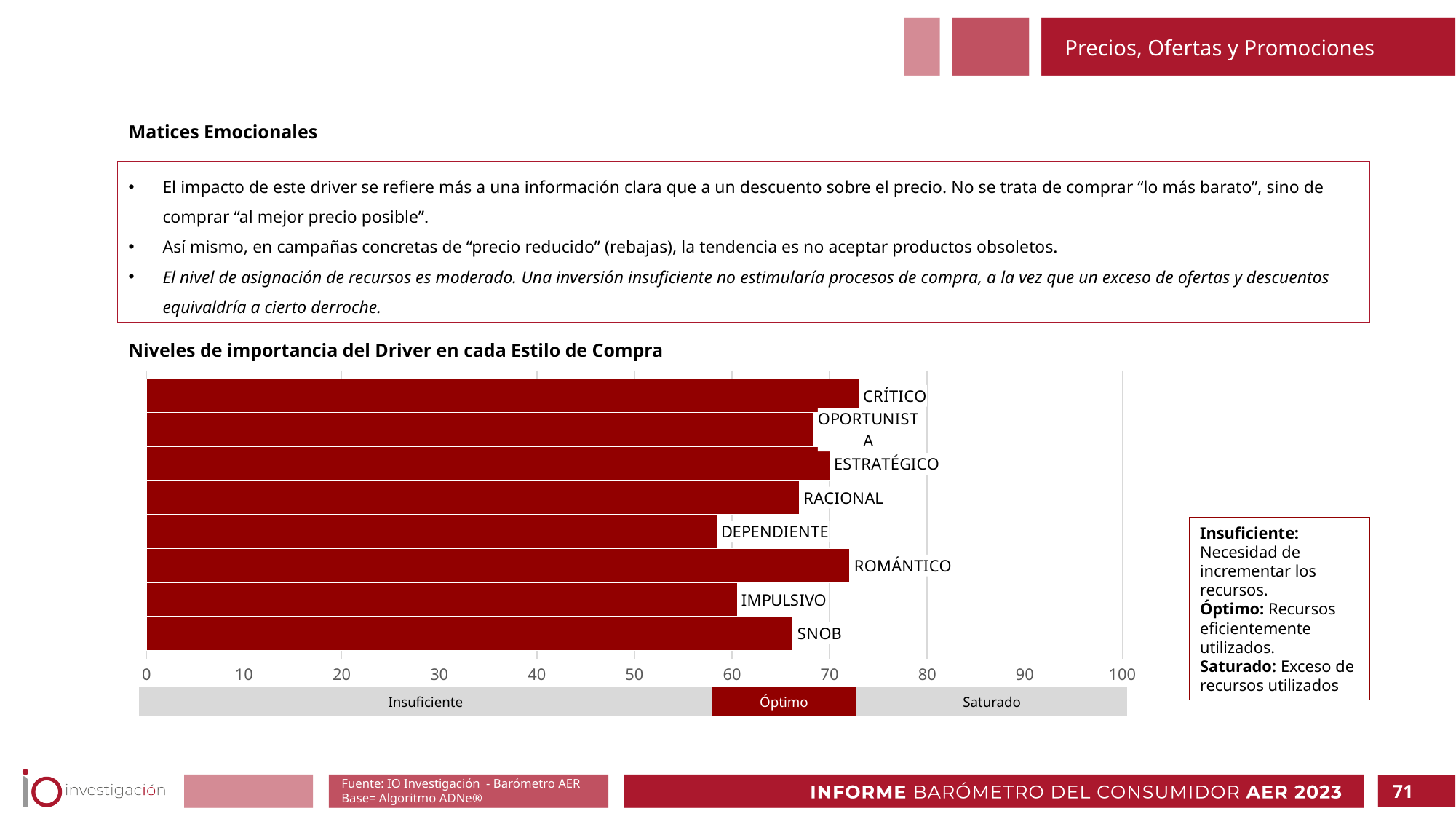
What are the three zone labels shown in the band below the x axis of the chart? Insuficiente, Óptimo, Saturado What is the title of the bar chart? Niveles de importancia del Driver en cada Estilo de Compra Is the value for RACIONAL greater or less than 70? less Which has the larger value, CRÍTICO or DEPENDIENTE? CRÍTICO Is the value for DEPENDIENTE greater or less than 60? less Which has the larger value, ROMÁNTICO or SNOB? ROMÁNTICO Is the value for ROMÁNTICO greater or less than 70? greater Which has the larger value, IMPULSIVO or CRÍTICO? CRÍTICO How many purchase styles (categories) are plotted in the bar chart? 8 What kind of chart is shown under 'Niveles de importancia del Driver en cada Estilo de Compra'? bar chart